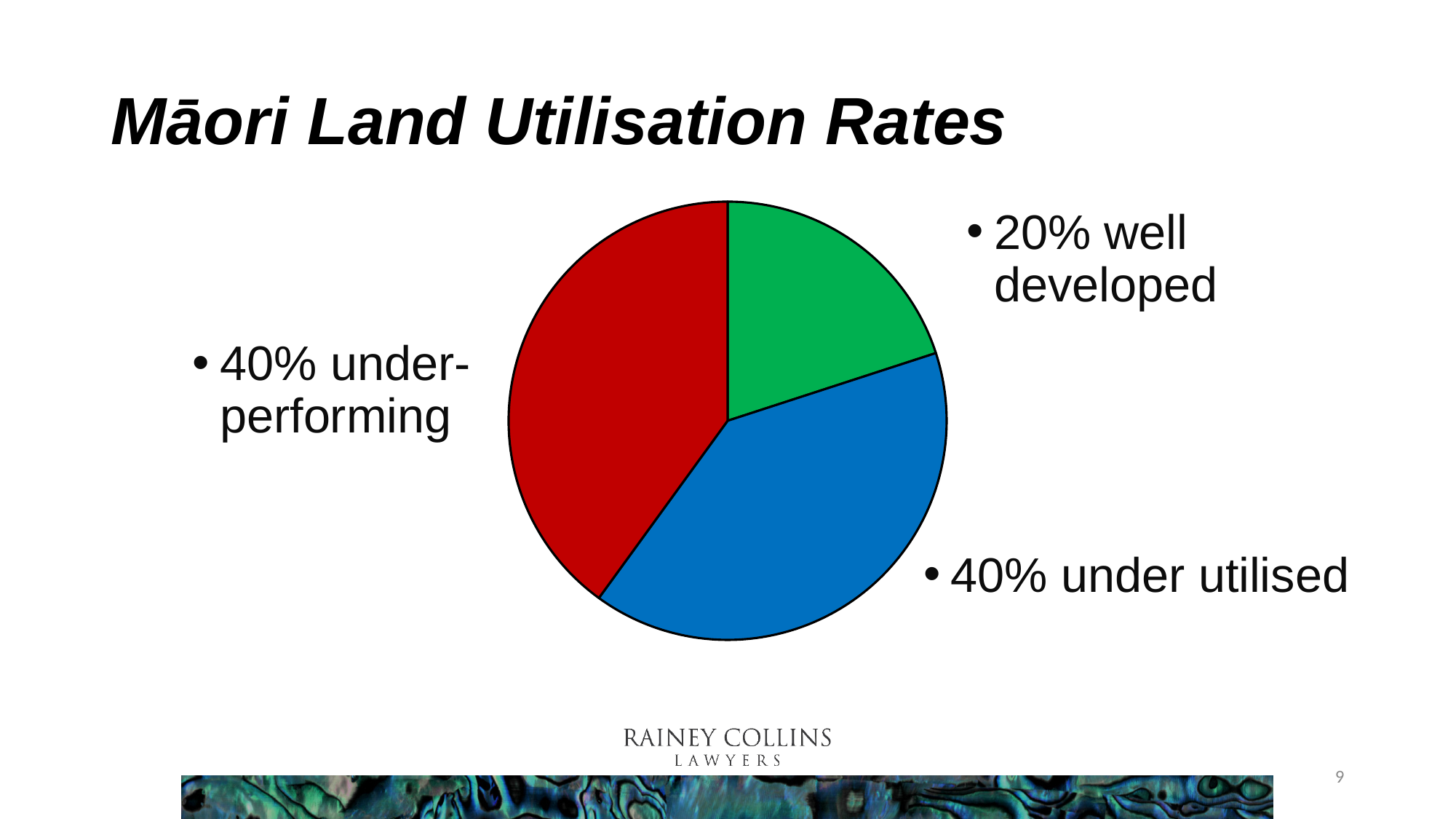
What share of Māori land is under utilised according to the chart? 40% What is the difference in percentage points between the under-performing share and the well developed share? 20 What share of Māori land is well developed according to the chart? 20% Which is larger: the share that is under utilised or the share that is well developed? under utilised What is the title of the slide containing the pie chart? Māori Land Utilisation Rates How many slices does the pie chart have? 3 What kind of chart is shown on the slide? pie chart Is the share of well developed land greater or less than 25%? less What share of Māori land is under-performing according to the chart? 40% Which category has the smallest share of the pie? well developed Which colour represents the well developed slice of the pie? green